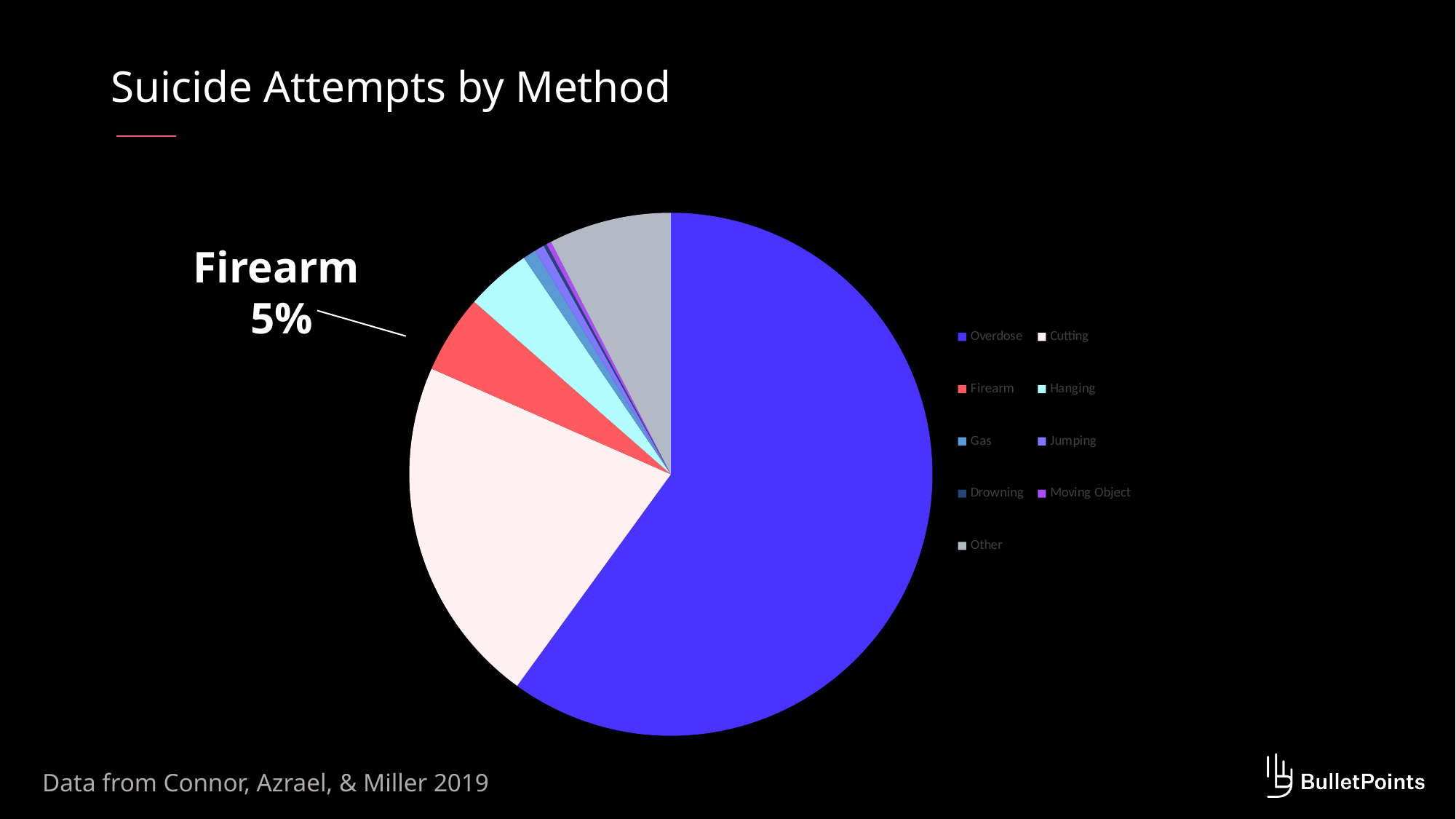
Which slice is larger, Other or Hanging? Other What kind of chart is shown on the slide? pie chart What share of suicide attempts is attributed to Firearm? 5% Which slice is larger, Overdose or Cutting? Overdose Which slice is larger, Cutting or Other? Cutting Which method accounts for the largest slice of the pie? Overdose What is the title of the chart? Suicide Attempts by Method Which method is the second-largest slice of the pie? Cutting How many methods (categories) does the legend list? 9 What colour is the Overdose slice? blue